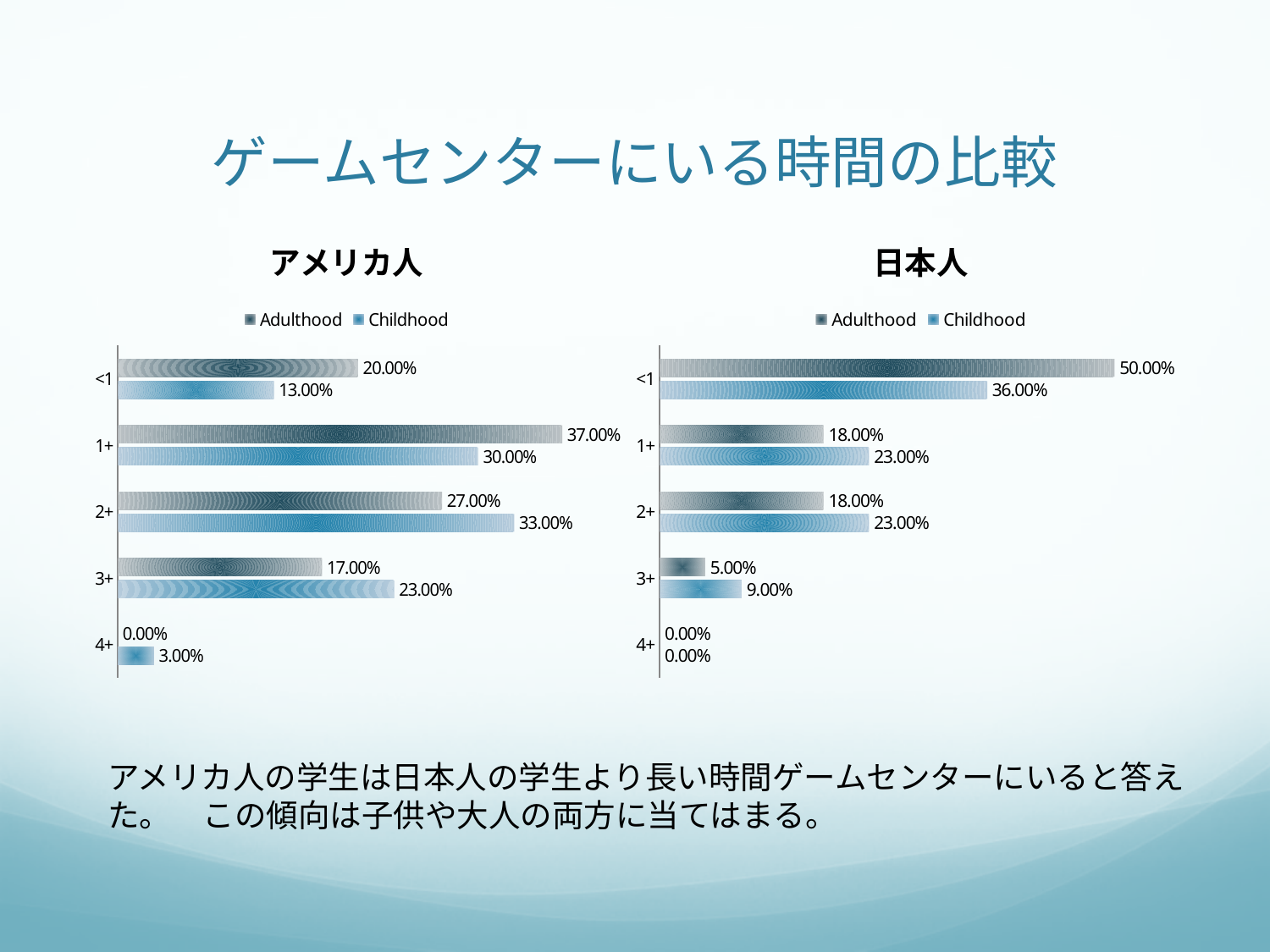
What are the two series named in the legend of the 日本人 chart? Adulthood and Childhood In the 日本人 chart, what is the Childhood value for the <1 category? 36.00% In the アメリカ人 chart, which is larger for the 2+ category, Adulthood or Childhood? Childhood In the アメリカ人 chart, what is the Adulthood value for the 1+ category? 37.00% In the 日本人 chart, which category has the highest Adulthood value? <1 In the アメリカ人 chart, what is the Childhood value for the 4+ category? 3.00% In the アメリカ人 chart, which category has the lowest Childhood value? 4+ In the 日本人 chart, what is the difference between the Childhood and Adulthood values for the 3+ category? 4.00% What kind of chart is the 日本人 chart? Bar chart In the アメリカ人 chart, what is the difference between the Adulthood and Childhood values for the 1+ category? 7.00% How many series does the legend of the アメリカ人 chart list? 2 How many categories are shown in the 日本人 chart? 5